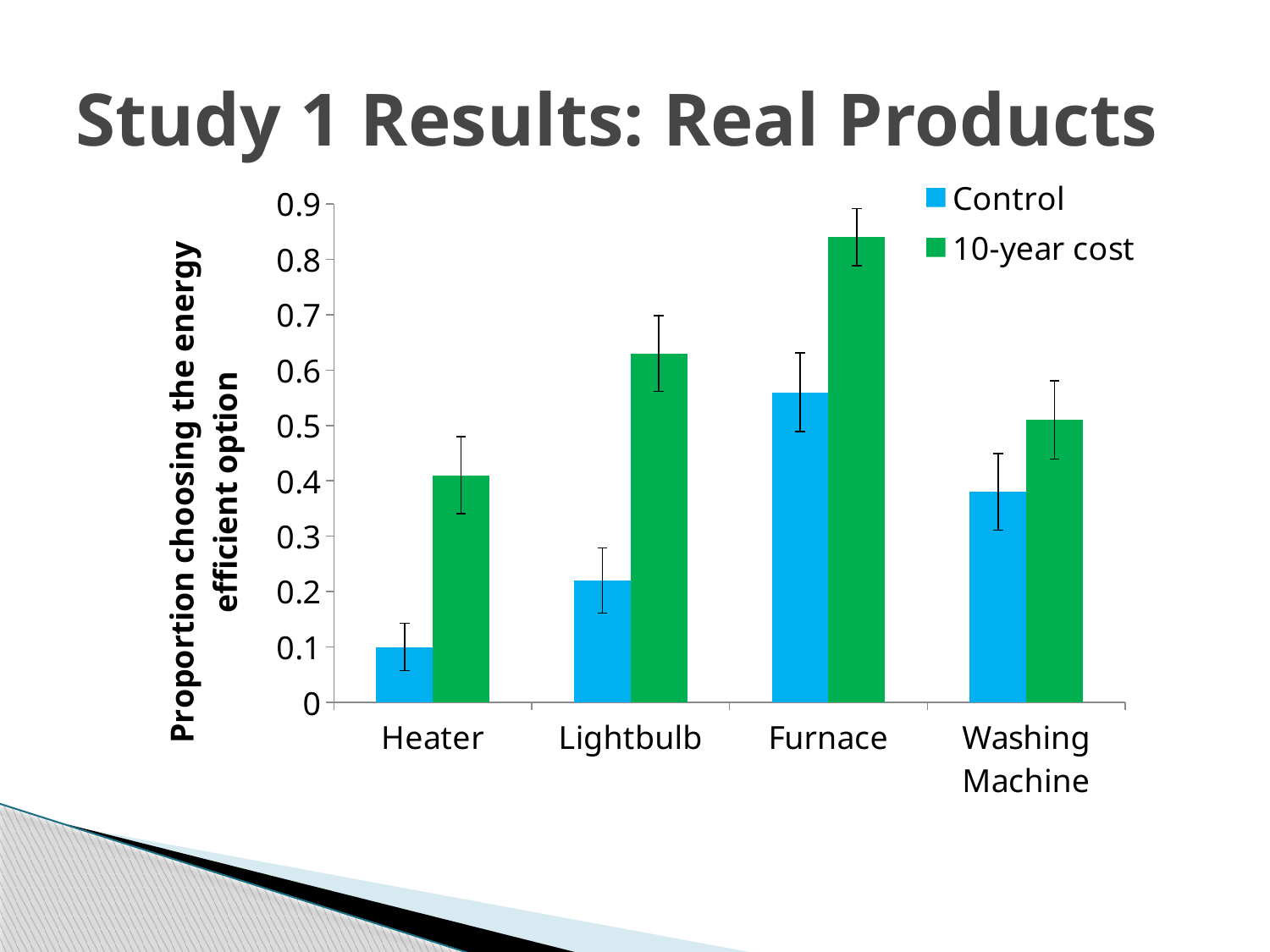
Is the value for Heater in the 10-year cost series greater or less than 0.5? less What kind of chart is shown on the slide? bar chart Which colour represents the Control series in the legend? blue Is the value for Washing Machine in the 10-year cost series greater or less than 0.4? greater Is the value for Lightbulb in the Control series greater or less than 0.3? less What is the y-axis label of the chart? Proportion choosing the energy efficient option Which product has the highest value for the 10-year cost series? Furnace How many series does the legend list? 2 Which product has the lowest value for the Control series? Heater For Lightbulb, which series has the larger value, Control or 10-year cost? 10-year cost How many product categories are shown on the x axis? 4